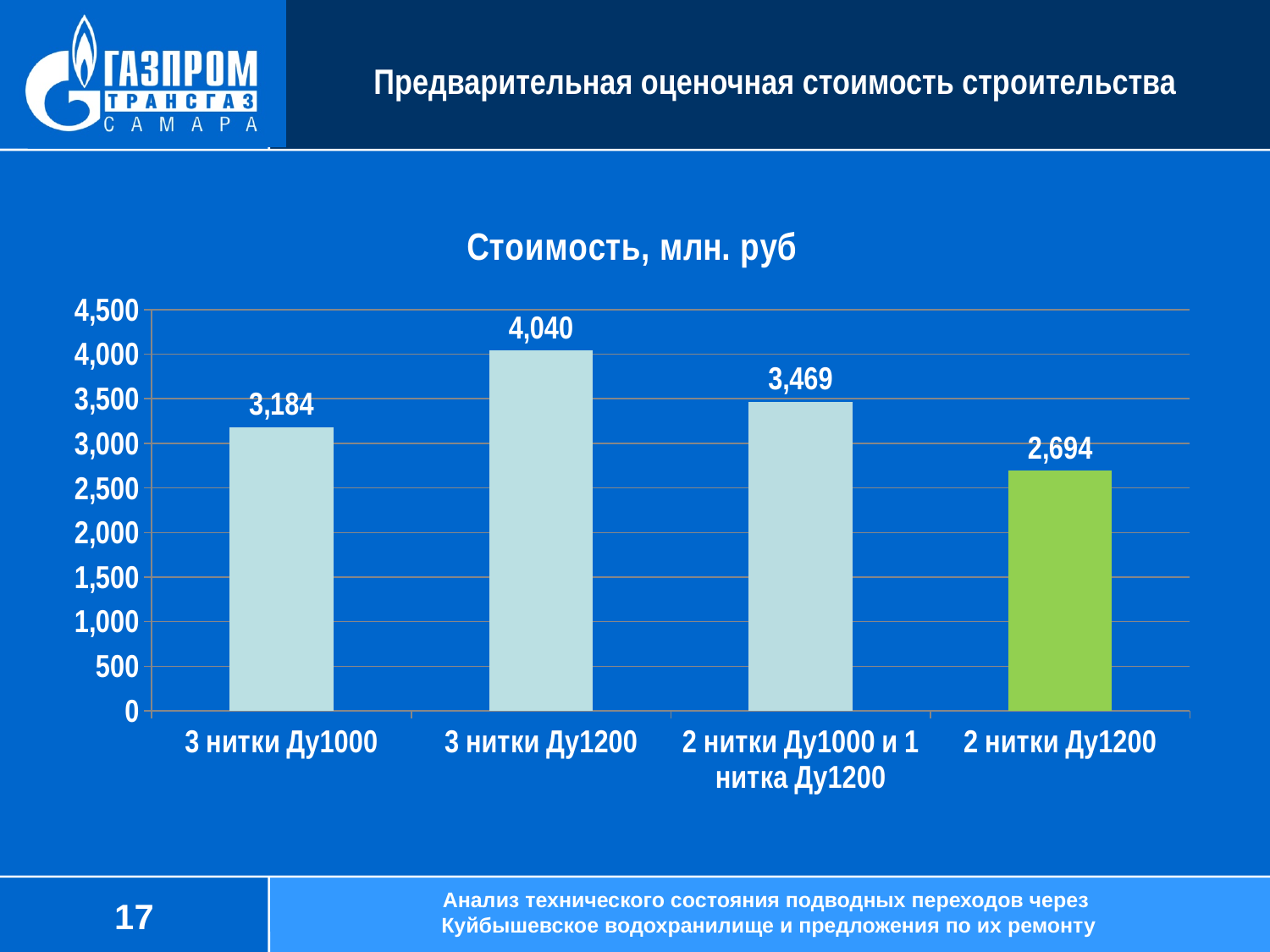
Which category has the highest value? 3 нитки Ду1200 What is the value for "2 нитки Ду1000 и 1 нитка Ду1200"? 3,469 What is the value for "2 нитки Ду1200"? 2,694 Which category has the lowest value? 2 нитки Ду1200 Which is larger, the value for "3 нитки Ду1000" or the value for "2 нитки Ду1000 и 1 нитка Ду1200"? 2 нитки Ду1000 и 1 нитка Ду1200 What is the title of the chart? Стоимость, млн. руб What kind of chart is shown on the slide? bar chart What is the value for "3 нитки Ду1000"? 3,184 What is the difference between the values for "2 нитки Ду1000 и 1 нитка Ду1200" and "3 нитки Ду1000"? 285 How many categories are shown on the x axis? 4 What is the difference between the values for "3 нитки Ду1200" and "2 нитки Ду1200"? 1,346 What is the value for "3 нитки Ду1200"? 4,040